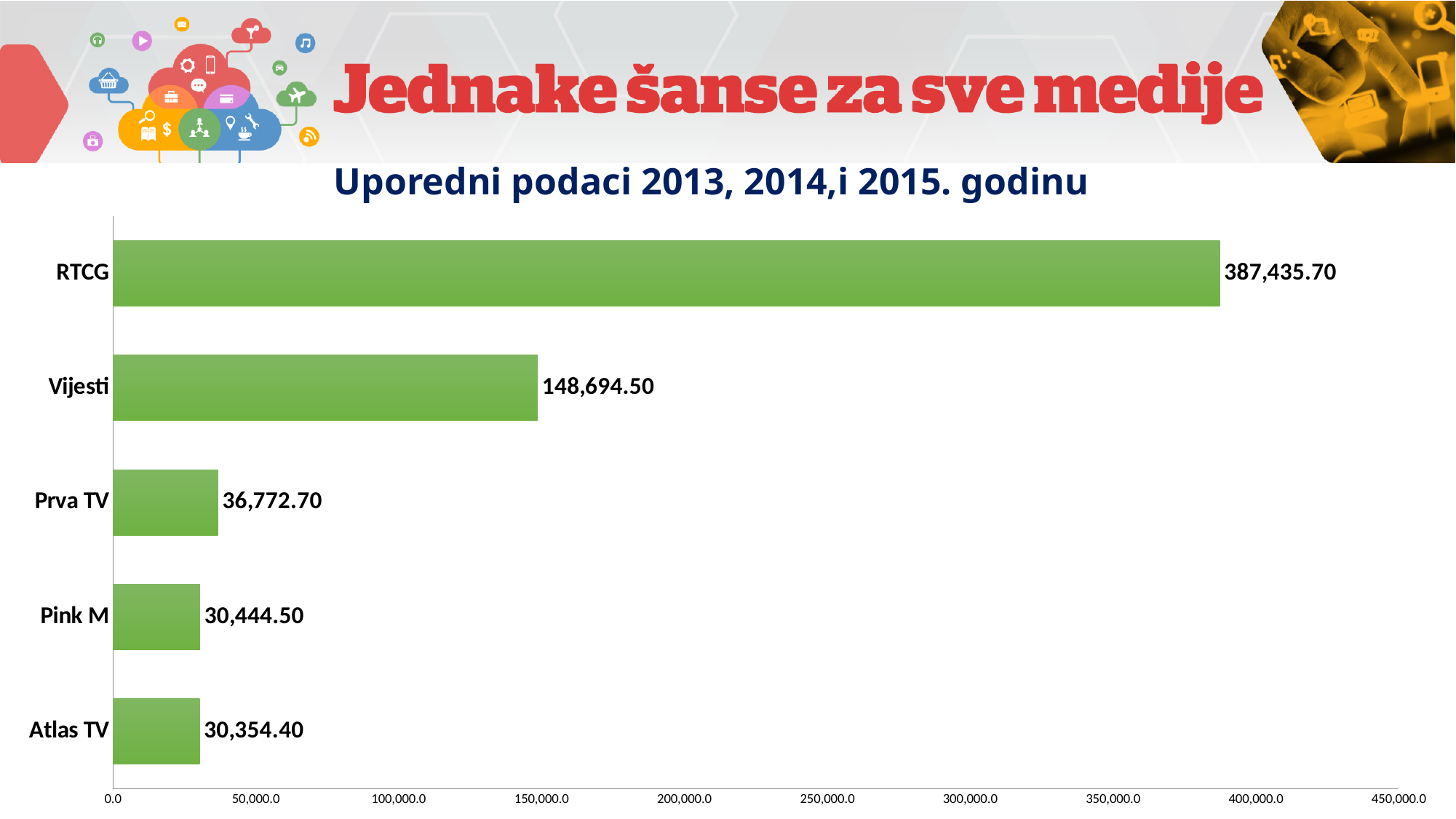
What is the difference between the values for Prva TV and Pink M? 6,328.20 What is the difference between the values for RTCG and Vijesti? 238,741.20 How many categories are shown in the chart? 5 Which is larger, the value for Vijesti or the value for Prva TV? Vijesti What is the value for Prva TV? 36,772.70 What kind of chart is shown on the slide? bar chart Which category has the lowest value? Atlas TV Which category has the highest value? RTCG Is the value for RTCG greater or less than 350,000.0? greater What is the value for RTCG? 387,435.70 What is the value for Vijesti? 148,694.50 What is the value for Atlas TV? 30,354.40